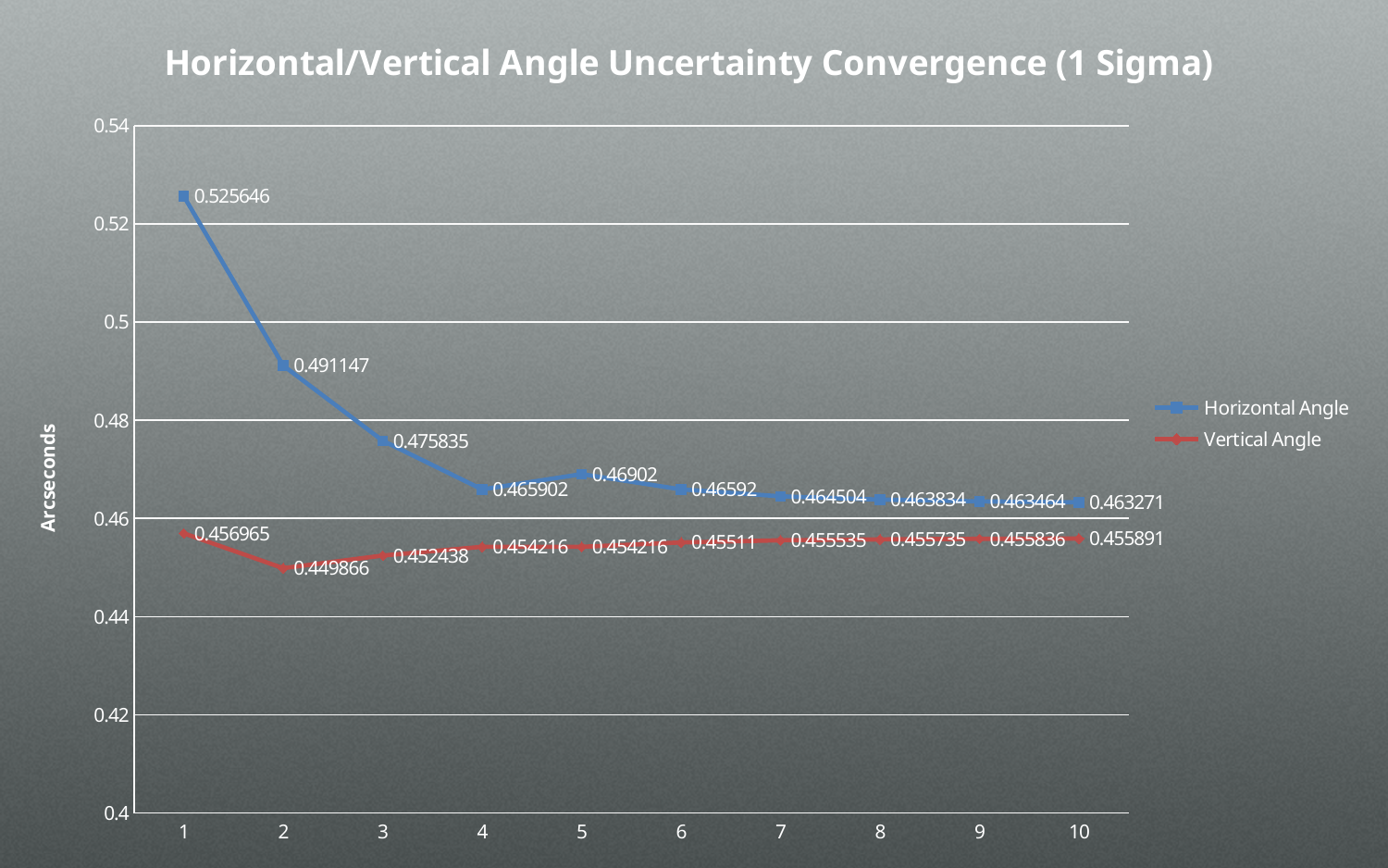
How many points are plotted along the x axis for each series? 10 At which x-axis point is the Horizontal Angle value highest? 1 What is the Horizontal Angle value at point 1? 0.525646 Which series has the larger value at point 5, Horizontal Angle or Vertical Angle? Horizontal Angle Is the Horizontal Angle value at point 2 greater or less than 0.5? less What is the Vertical Angle value at point 2? 0.449866 How many series does the legend list? 2 What is the difference between the Horizontal Angle and Vertical Angle values at point 1? 0.068681 At which x-axis point is the Vertical Angle value lowest? 2 What is the Horizontal Angle value at point 10? 0.463271 What is the Vertical Angle value at point 6? 0.45511 What type of chart is shown on the slide? Line chart